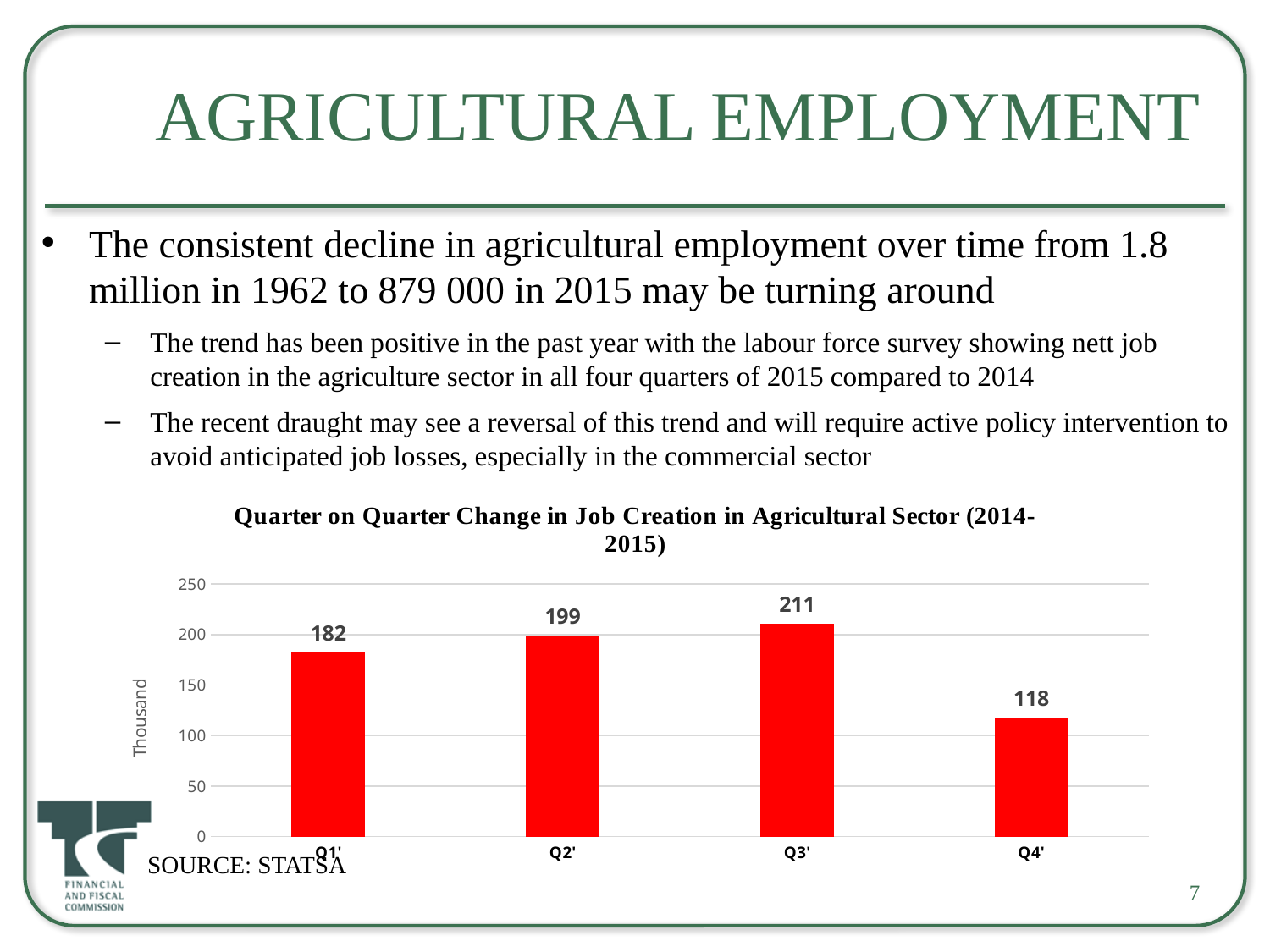
Which is larger, the value for Q1' or the value for Q2'? Q2' Is the value for Q3' greater or less than 200? greater What is the value for Q2' in the chart? 199 Which quarter has the lowest value? Q4' What is the difference between the values for Q3' and Q4'? 93 What kind of chart is shown on the slide? bar chart What unit is shown on the vertical axis of the chart? Thousand How many quarters are shown in the chart? 4 Which quarter has the highest value? Q3' What is the difference between the values for Q2' and Q1'? 17 What is the value for Q1' in the chart? 182 What is the value for Q4' in the chart? 118